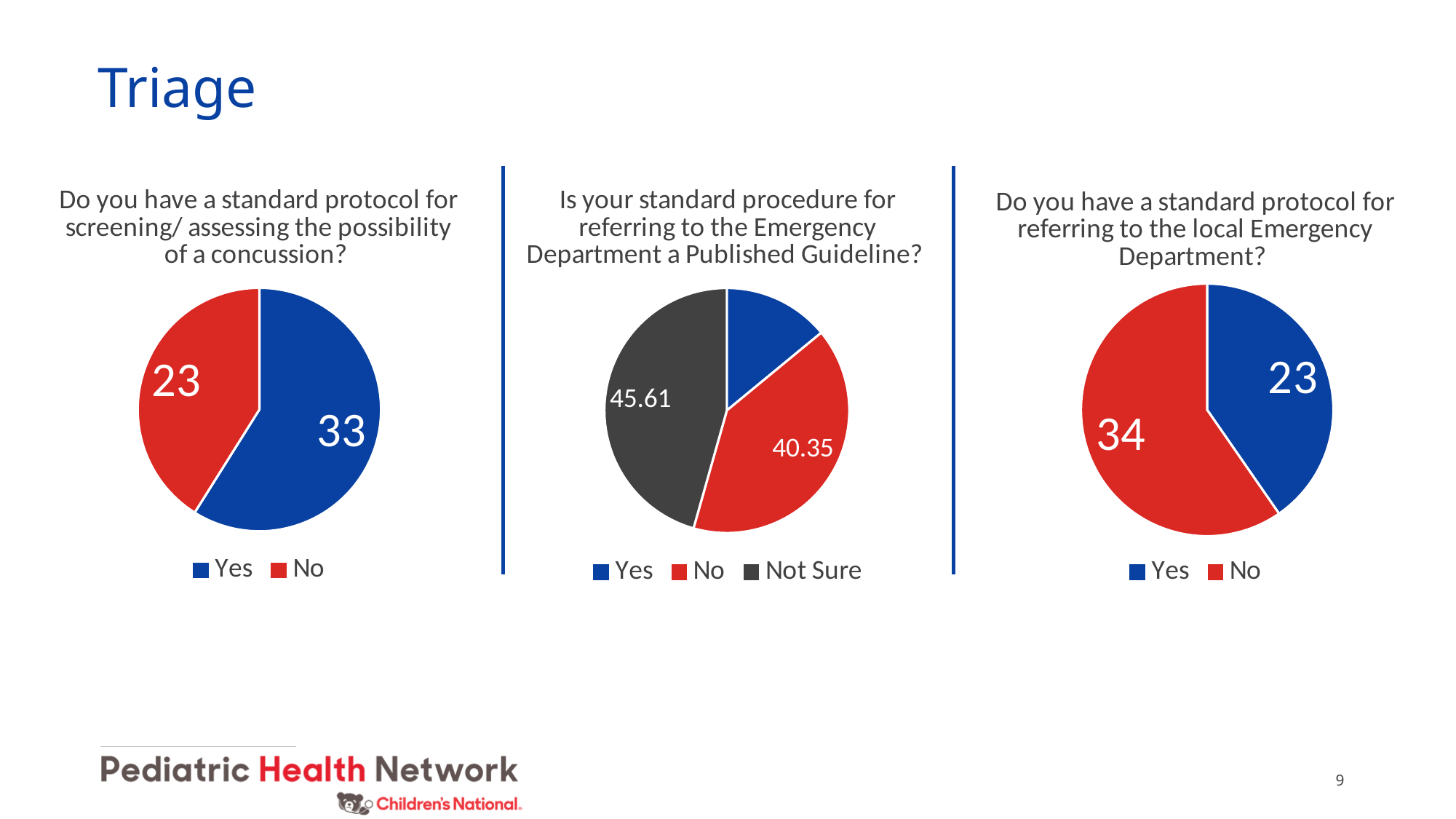
In the middle pie chart, what colour is the Not Sure slice? Dark grey In the left pie chart (standard protocol for screening/assessing a concussion), what is the value for Yes? 33 In the left pie chart (standard protocol for screening/assessing a concussion), what is the difference between Yes and No? 10 How many categories does the legend of the middle pie chart list? 3 In the left pie chart (standard protocol for screening/assessing a concussion), what is the value for No? 23 What kind of chart is used for the question about a standard protocol for screening/assessing a concussion? Pie chart In the middle pie chart (standard procedure for referring to the Emergency Department a Published Guideline), which category is the smallest? Yes In the middle pie chart (standard procedure for referring to the Emergency Department a Published Guideline), what is the value for No? 40.35 In the middle pie chart (standard procedure for referring to the Emergency Department a Published Guideline), what is the value for Not Sure? 45.61 In the right pie chart (standard protocol for referring to the local Emergency Department), which is larger, Yes or No? No In the right pie chart (standard protocol for referring to the local Emergency Department), what is the value for No? 34 In the right pie chart (standard protocol for referring to the local Emergency Department), which category is the largest? No